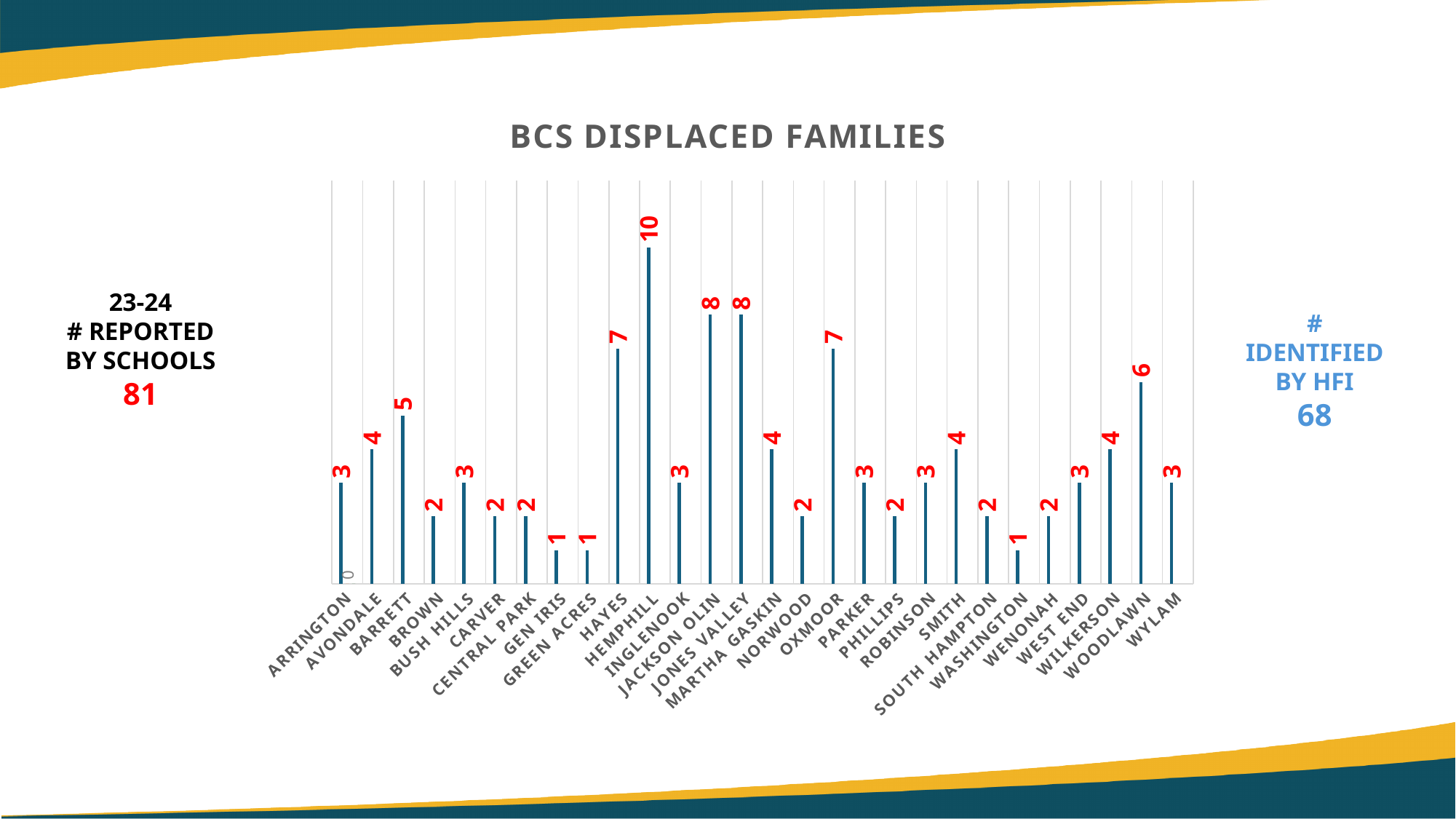
Which is larger, the value for OXMOOR or the value for WOODLAWN? OXMOOR What is the difference between the values for HEMPHILL and JACKSON OLIN? 2 What is the value for MARTHA GASKIN? 4 What kind of chart is this? Bar chart What is the value for WOODLAWN? 6 What is the difference between the values for HAYES and WASHINGTON? 6 Which is larger, the value for AVONDALE or the value for BROWN? AVONDALE Which school has the highest value? HEMPHILL What is the value for HEMPHILL? 10 How many schools are shown on the x axis? 28 What is the title of the chart? BCS DISPLACED FAMILIES What is the value for BARRETT? 5